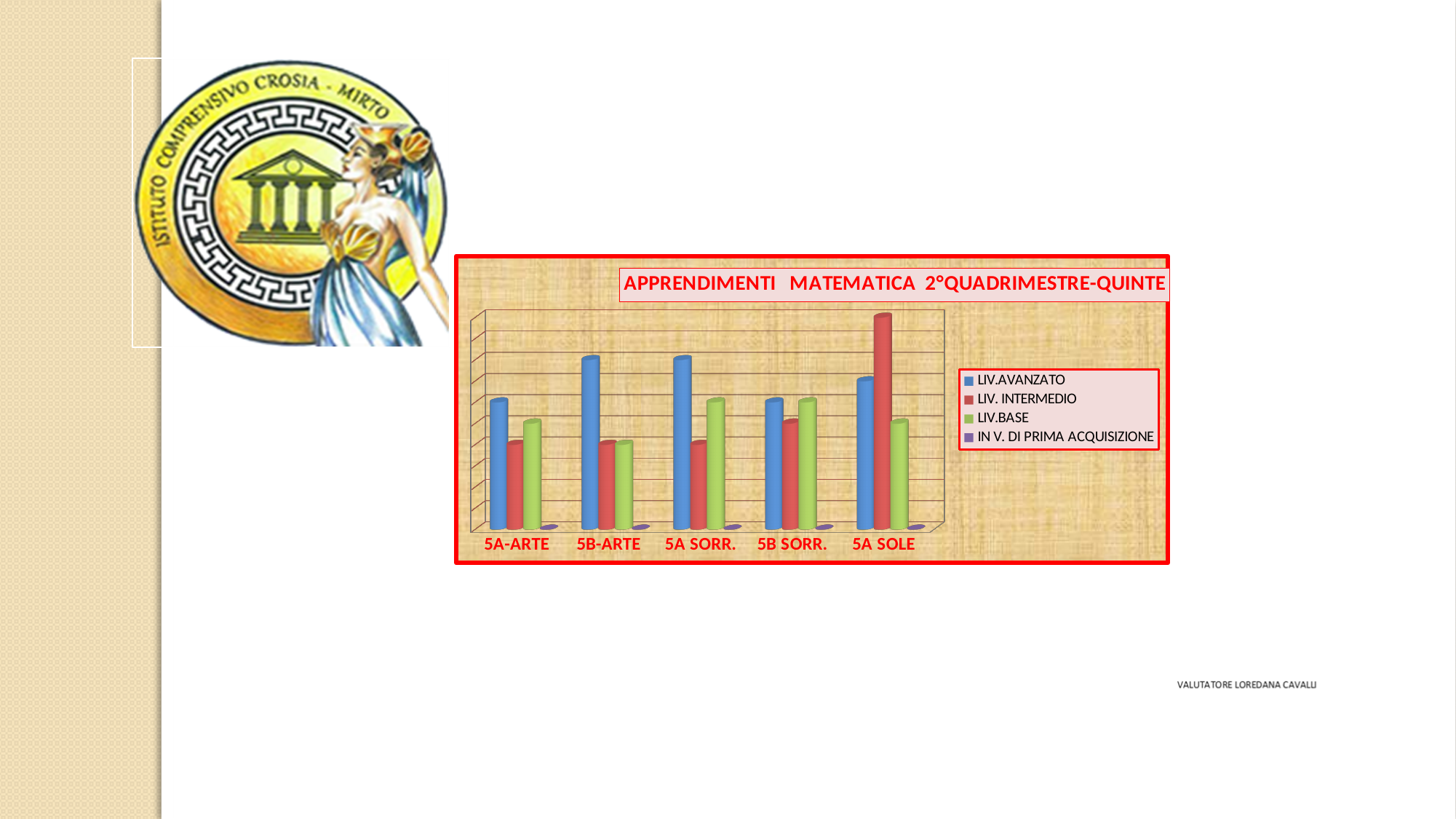
For 5A-ARTE, which is larger: LIV.AVANZATO or LIV. INTERMEDIO? LIV.AVANZATO How many classes (categories) are shown on the x axis of the chart? 5 How many series does the chart's legend list? 4 Which colour represents LIV.BASE in the chart? green For 5B-ARTE, which is larger: LIV.AVANZATO or LIV.BASE? LIV.AVANZATO For which class is the LIV. INTERMEDIO bar the highest? 5A SOLE For 5A SORR., which is larger: LIV.BASE or LIV. INTERMEDIO? LIV.BASE What is the title of the chart? APPRENDIMENTI MATEMATICA 2°QUADRIMESTRE-QUINTE Which class has the single tallest bar in the chart? 5A SOLE For which class is the LIV.BASE bar the lowest? 5B-ARTE What kind of chart is shown on the slide? bar chart